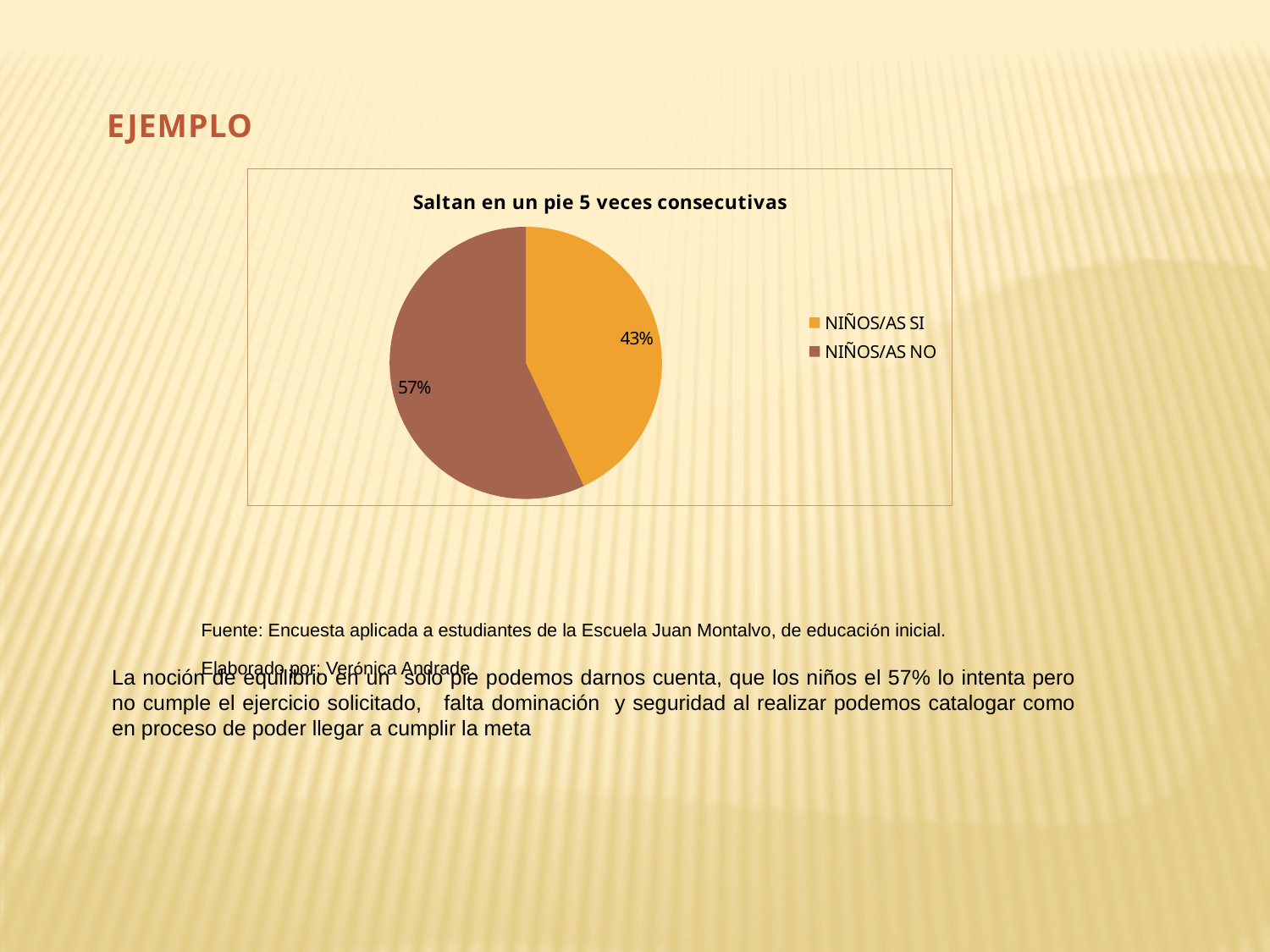
What is the difference in percentage points between NIÑOS/AS NO and NIÑOS/AS SI? 14 What is the title of the chart? Saltan en un pie 5 veces consecutivas Which category has the largest slice of the pie? NIÑOS/AS NO What share of the pie does NIÑOS/AS NO represent? 57% What share of the pie does NIÑOS/AS SI represent? 43% Which category has the smallest slice of the pie? NIÑOS/AS SI How many slices does the pie chart have? 2 Which colour represents NIÑOS/AS SI in the chart? Orange Which is larger, the slice for NIÑOS/AS SI or the slice for NIÑOS/AS NO? NIÑOS/AS NO How many entries does the legend list? 2 What kind of chart is shown on the slide? Pie chart